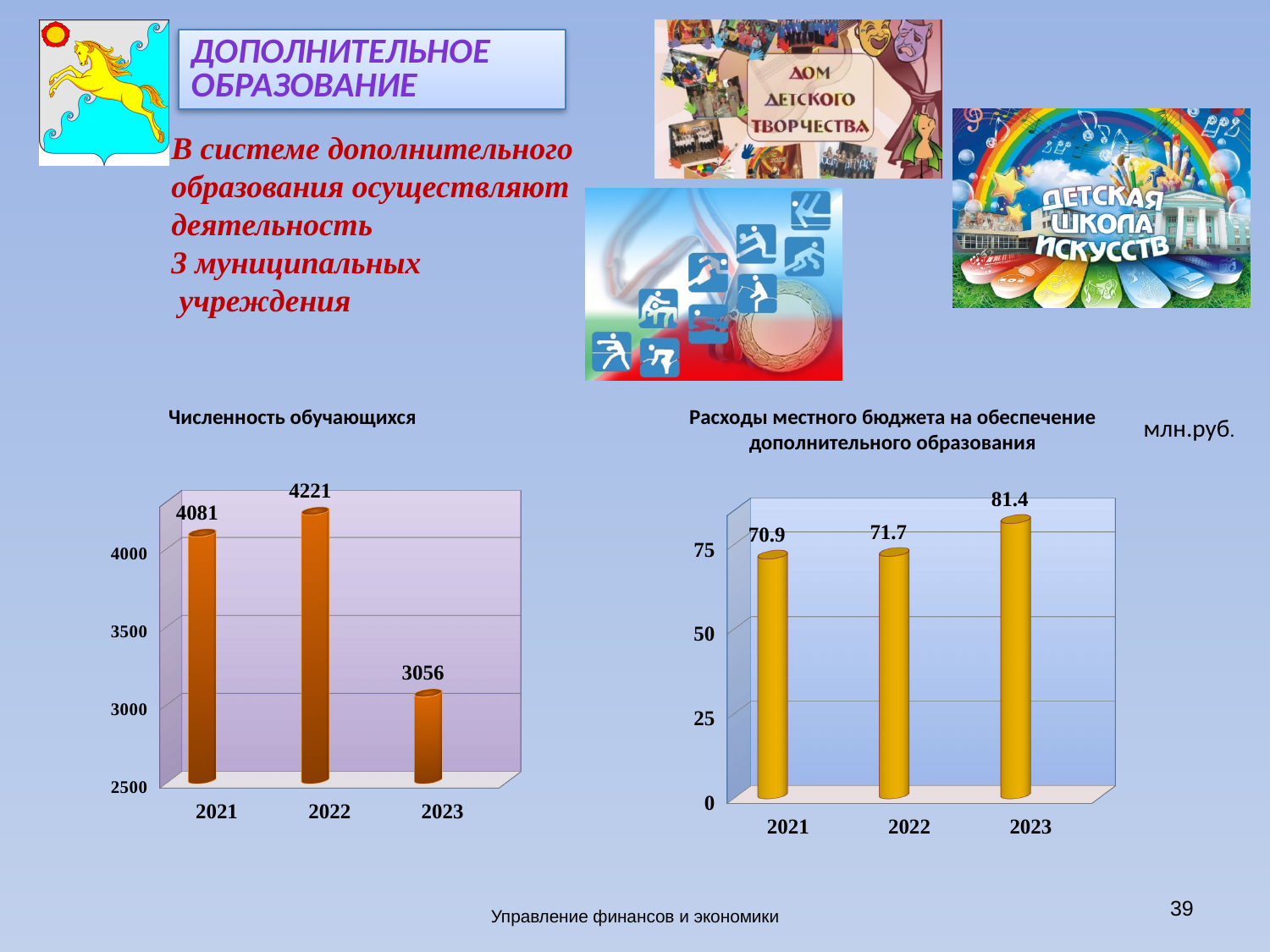
In the 'Численность обучающихся' chart, what is the value for 2022? 4221 In the 'Численность обучающихся' chart, how many years are shown? 3 In the 'Расходы местного бюджета на обеспечение дополнительного образования' chart, what is the difference between the values for 2023 and 2021? 10.5 In the 'Численность обучающихся' chart, what is the difference between the values for 2022 and 2023? 1165 In the 'Расходы местного бюджета на обеспечение дополнительного образования' chart, do the values rise or fall from 2021 to 2023? rise In the 'Расходы местного бюджета на обеспечение дополнительного образования' chart, what is the value for 2021? 70.9 In the 'Численность обучающихся' chart, what is the value for 2023? 3056 In the 'Численность обучающихся' chart, which year has the highest value? 2022 What kind of chart is the 'Расходы местного бюджета на обеспечение дополнительного образования' chart? bar chart In the 'Расходы местного бюджета на обеспечение дополнительного образования' chart, what is the value for 2023? 81.4 In the 'Расходы местного бюджета на обеспечение дополнительного образования' chart, which year has the highest value? 2023 In the 'Численность обучающихся' chart, which year has the lowest value? 2023